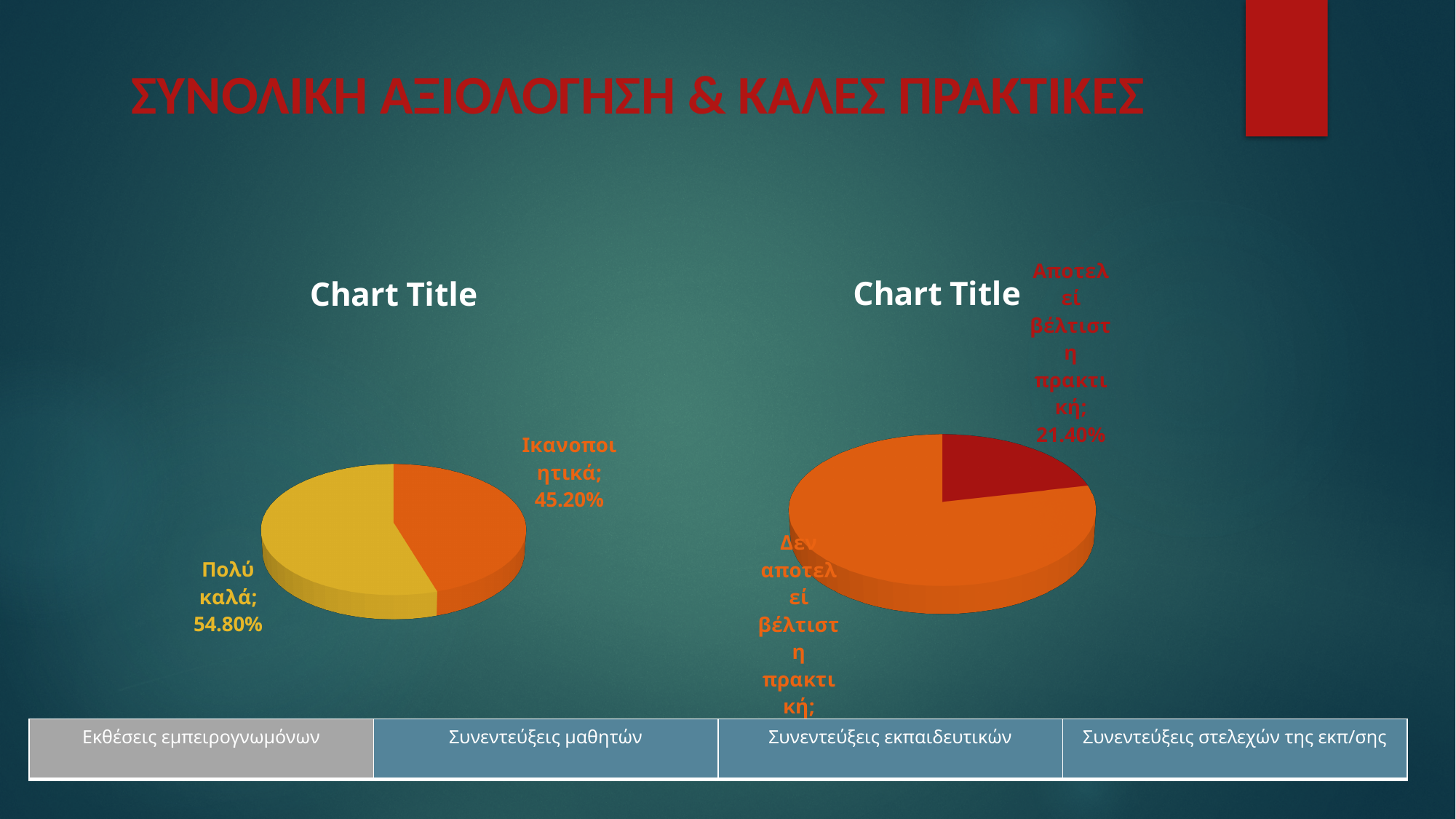
What type of chart is the right chart on the slide? Pie chart In the left pie chart, which category has the largest slice? Πολύ καλά In the left pie chart, which category has the smallest slice? Ικανοποιητικά What is the title shown above the left pie chart? Chart Title In the left pie chart, what is the difference between the Πολύ καλά and Ικανοποιητικά values? 9.60% In the left pie chart, what is the value for Ικανοποιητικά? 45.20% What type of chart is the left chart on the slide? Pie chart In the left pie chart, what is the value for Πολύ καλά? 54.80% In the right pie chart, which slice is larger: Αποτελεί βέλτιστη πρακτική or Δεν αποτελεί βέλτιστη πρακτική? Δεν αποτελεί βέλτιστη πρακτική How many slices does the right pie chart have? 2 In the right pie chart, what is the value for Αποτελεί βέλτιστη πρακτική? 21.40% How many slices does the left pie chart have? 2